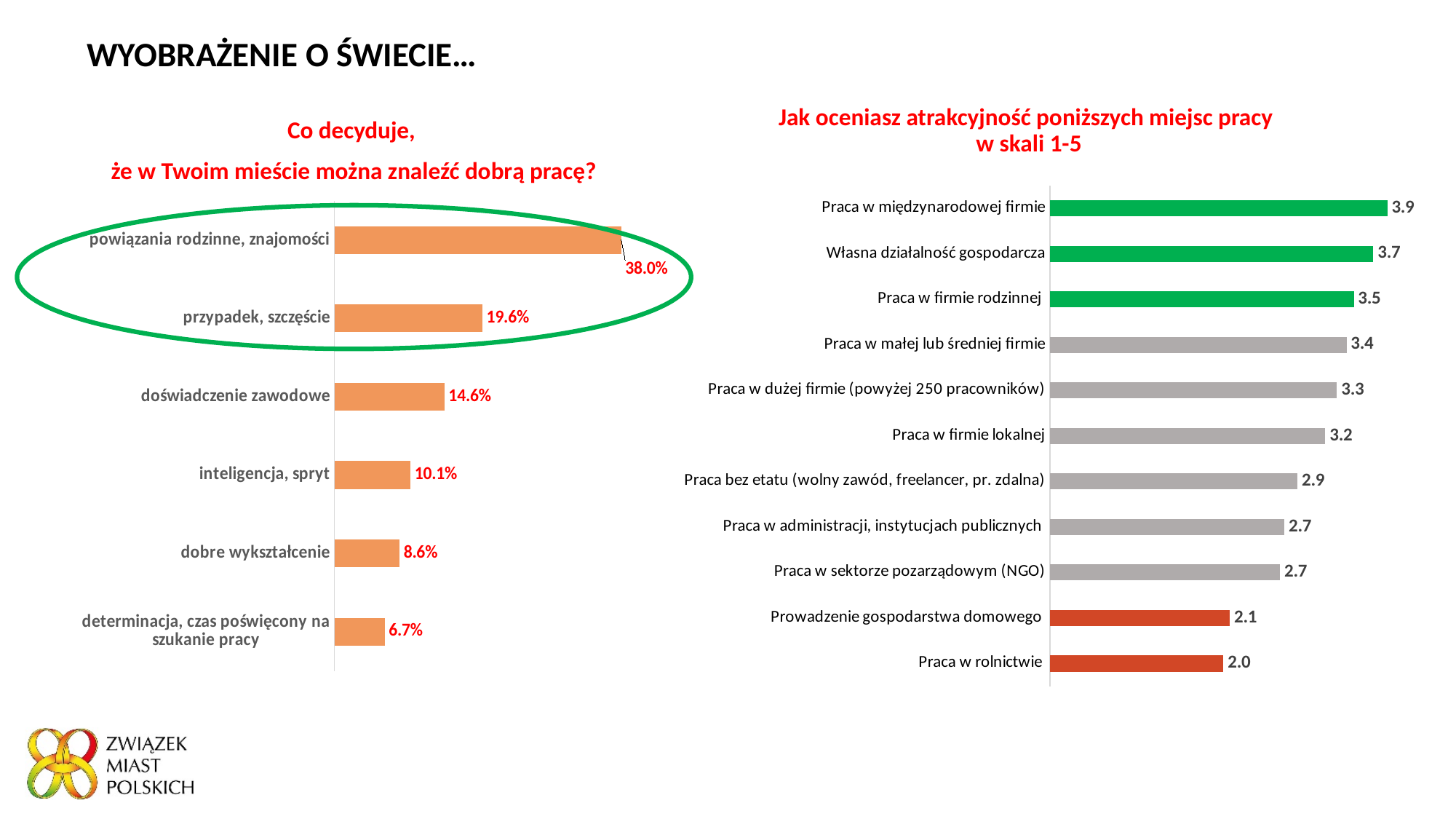
In the left chart ("Co decyduje, że w Twoim mieście można znaleźć dobrą pracę?"), which category has the lowest value? determinacja, czas poświęcony na szukanie pracy In the right chart ("Jak oceniasz atrakcyjność poniższych miejsc pracy w skali 1-5"), what is the difference between "Własna działalność gospodarcza" and "Prowadzenie gospodarstwa domowego"? 1.6 In the left chart ("Co decyduje, że w Twoim mieście można znaleźć dobrą pracę?"), what is the value for "dobre wykształcenie"? 8.6% In the right chart ("Jak oceniasz atrakcyjność poniższych miejsc pracy w skali 1-5"), which is larger: "Praca w małej lub średniej firmie" or "Praca bez etatu (wolny zawód, freelancer, pr. zdalna)"? Praca w małej lub średniej firmie In the left chart ("Co decyduje, że w Twoim mieście można znaleźć dobrą pracę?"), what is the difference between "przypadek, szczęście" and "doświadczenie zawodowe"? 5.0% In the left chart ("Co decyduje, że w Twoim mieście można znaleźć dobrą pracę?"), how many categories are shown? 6 In the left chart ("Co decyduje, że w Twoim mieście można znaleźć dobrą pracę?"), what is the value for "powiązania rodzinne, znajomości"? 38.0% What type of chart is the right chart ("Jak oceniasz atrakcyjność poniższych miejsc pracy w skali 1-5")? Bar chart In the right chart ("Jak oceniasz atrakcyjność poniższych miejsc pracy w skali 1-5"), how many categories are shown? 11 In the right chart ("Jak oceniasz atrakcyjność poniższych miejsc pracy w skali 1-5"), which category has the lowest value? Praca w rolnictwie In the right chart ("Jak oceniasz atrakcyjność poniższych miejsc pracy w skali 1-5"), which category has the highest value? Praca w międzynarodowej firmie In the right chart ("Jak oceniasz atrakcyjność poniższych miejsc pracy w skali 1-5"), what is the value for "Praca w firmie lokalnej"? 3.2